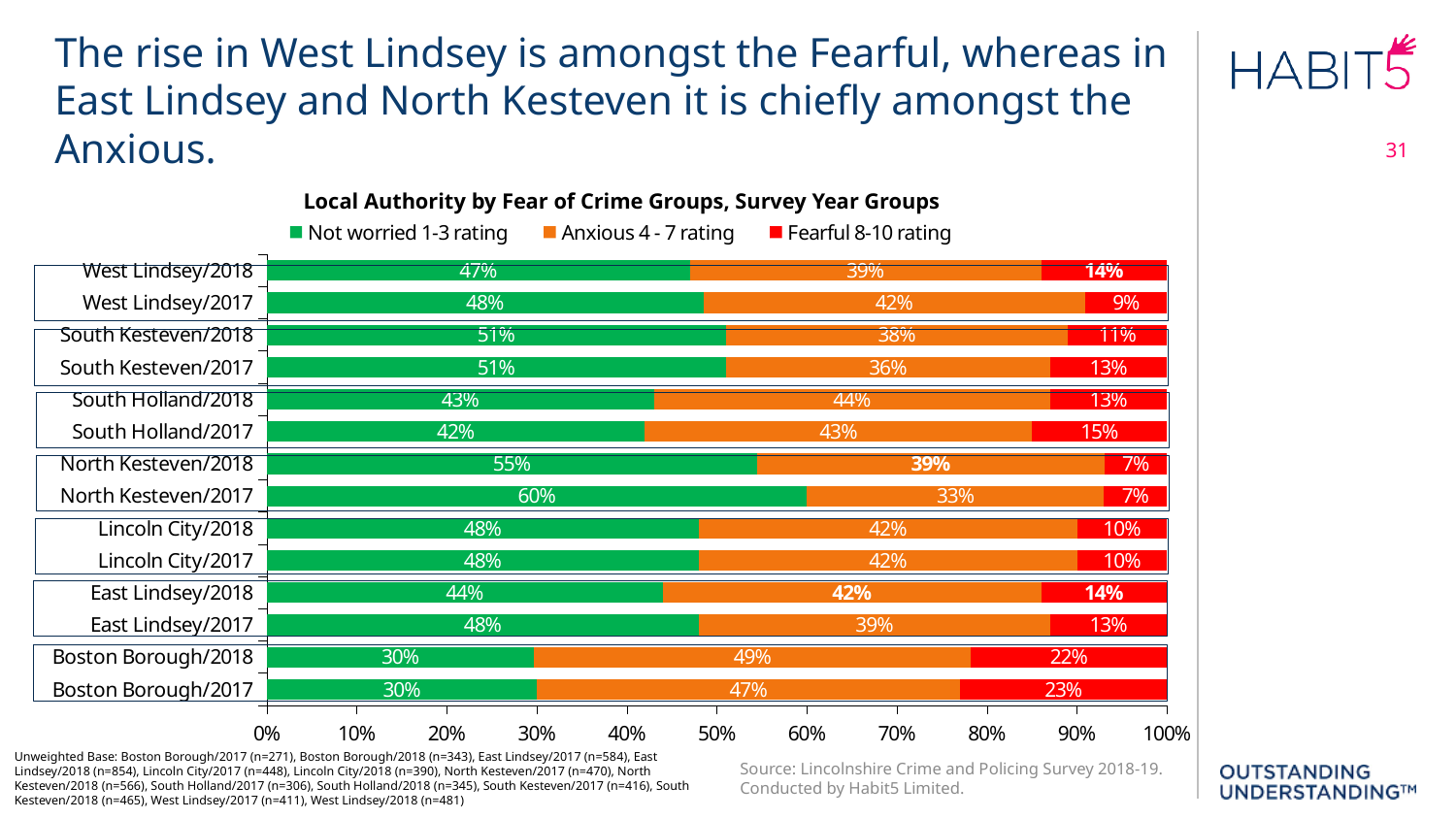
How many series does the legend list? 3 What is the title of the chart? Local Authority by Fear of Crime Groups, Survey Year Groups Which colour represents the Fearful 8-10 rating series? Red Which category has the highest Not worried 1-3 rating value? North Kesteven/2017 Which category has the highest Fearful 8-10 rating value? Boston Borough/2017 How many category bars are plotted in the chart? 14 What is the difference between the Fearful 8-10 rating values for West Lindsey/2018 and West Lindsey/2017? 5% What type of chart is shown on the slide? Stacked bar chart What is the Not worried 1-3 rating value for North Kesteven/2017? 60% Which is larger, the Anxious 4 - 7 rating for East Lindsey/2018 or for East Lindsey/2017? East Lindsey/2018 What is the Fearful 8-10 rating value for West Lindsey/2018? 14% What is the Anxious 4 - 7 rating value for Boston Borough/2018? 49%